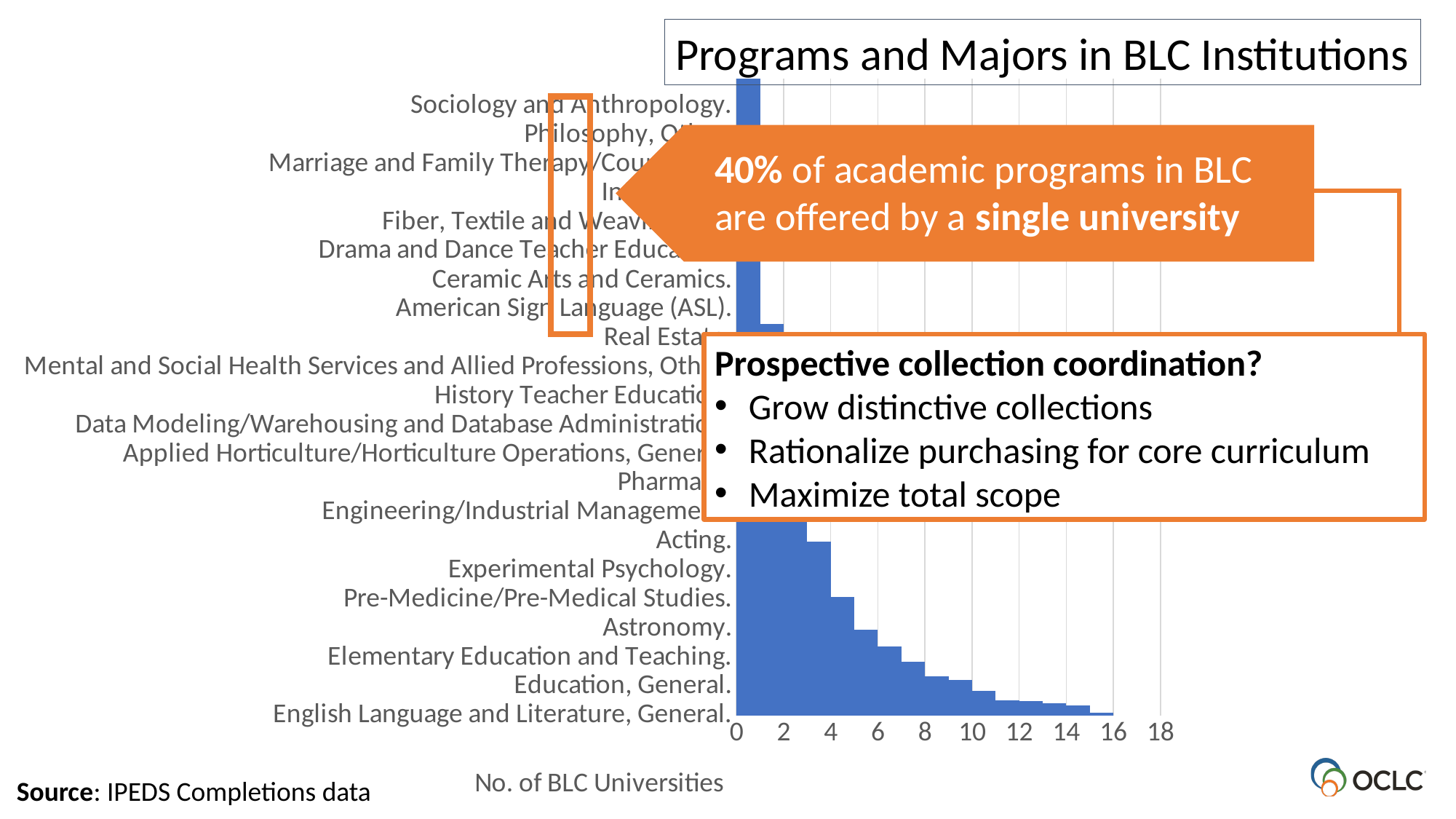
Is the value for Astronomy greater or less than 10? less Is the value for Sociology and Anthropology greater or less than 2? less Do the bar lengths increase or decrease going from the top of the chart to the bottom? increase What kind of chart is shown on the slide? bar chart Is the value for Acting greater or less than 6? less Which has the larger value, Education, General or Astronomy? Education, General Which program has the longest bar in the chart? English Language and Literature, General What is the title of the chart? Programs and Majors in BLC Institutions What is the label of the horizontal axis of the chart? No. of BLC Universities Which has the larger value, Elementary Education and Teaching or Experimental Psychology? Elementary Education and Teaching